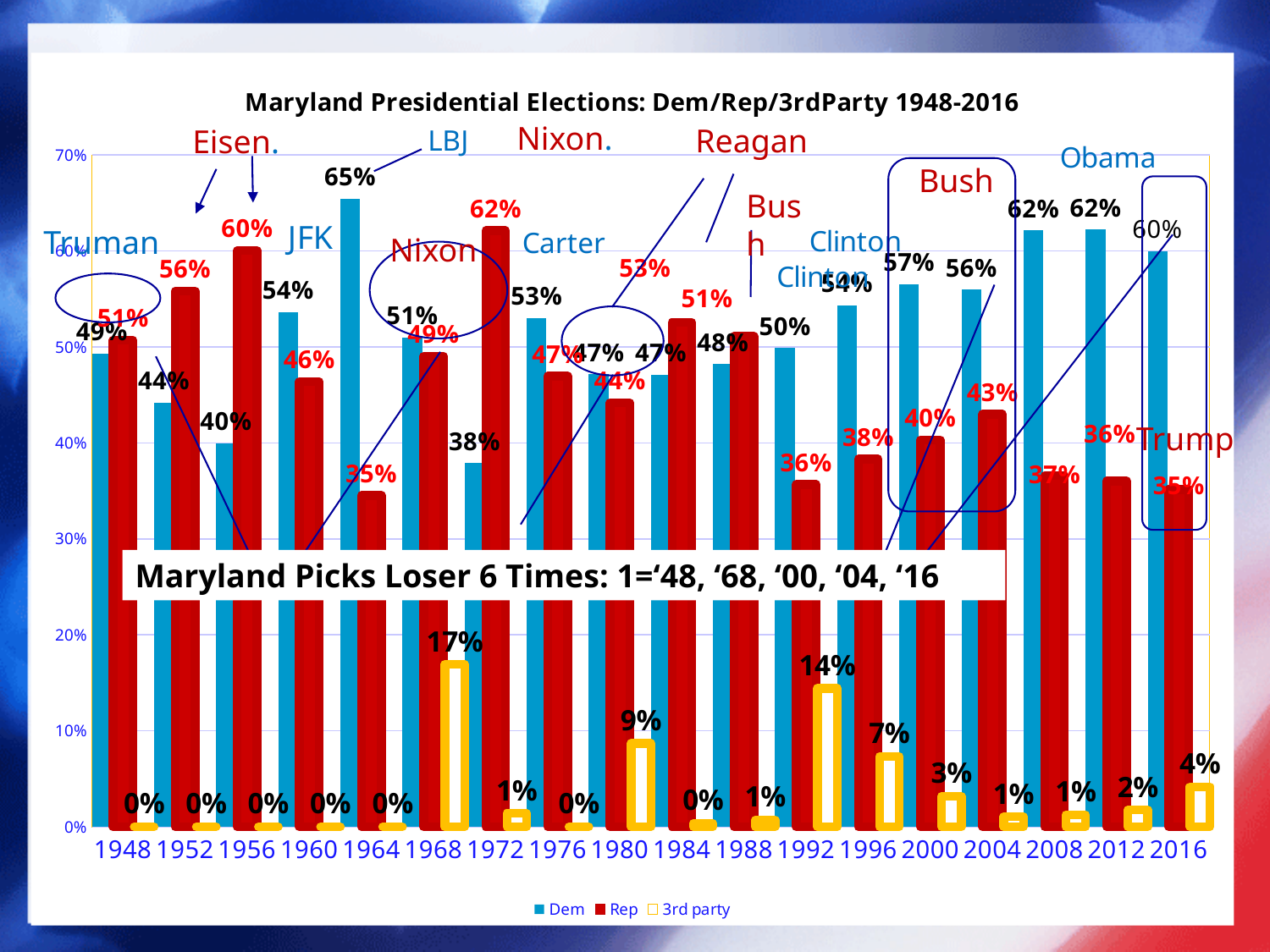
In which year is the Dem value lowest? 1972 In which year is the Dem value highest? 1964 What type of chart is shown on the slide? bar chart What is the title of the chart? Maryland Presidential Elections: Dem/Rep/3rdParty 1948-2016 What is the Rep value for 1972? 62% What is the Dem value for 1964? 65% What is the difference between the Dem and Rep values in 1992? 14% What is the 3rd party value for 1968? 17% Which is larger in 1956, the Dem value or the Rep value? Rep In which year is the 3rd party value highest? 1968 How many election years are shown on the x axis? 18 How many series does the legend list? 3